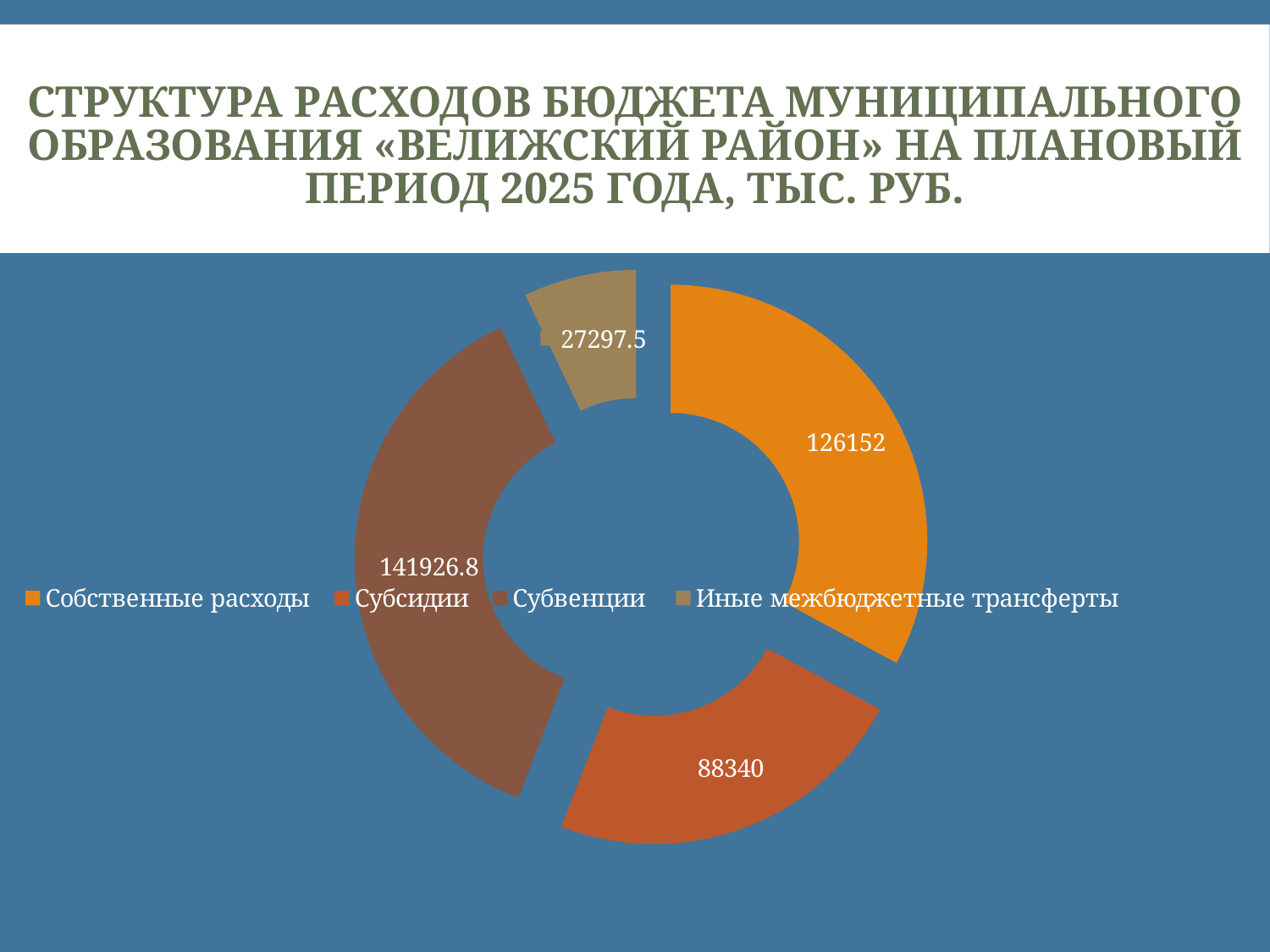
What colour is the slice for Собственные расходы? Orange What is the value for Собственные расходы? 126152 What is the value for Иные межбюджетные трансферты? 27297.5 What is the difference between the values for Субвенции and Собственные расходы? 15774.8 What is the difference between the values for Собственные расходы and Субсидии? 37812 Which category has the highest value? Субвенции What kind of chart is shown on the slide? Doughnut chart What is the value for Субсидии? 88340 How many categories does the chart show? 4 What is the value for Субвенции? 141926.8 Which category has the lowest value? Иные межбюджетные трансферты Which is larger, the value for Субсидии or the value for Иные межбюджетные трансферты? Субсидии